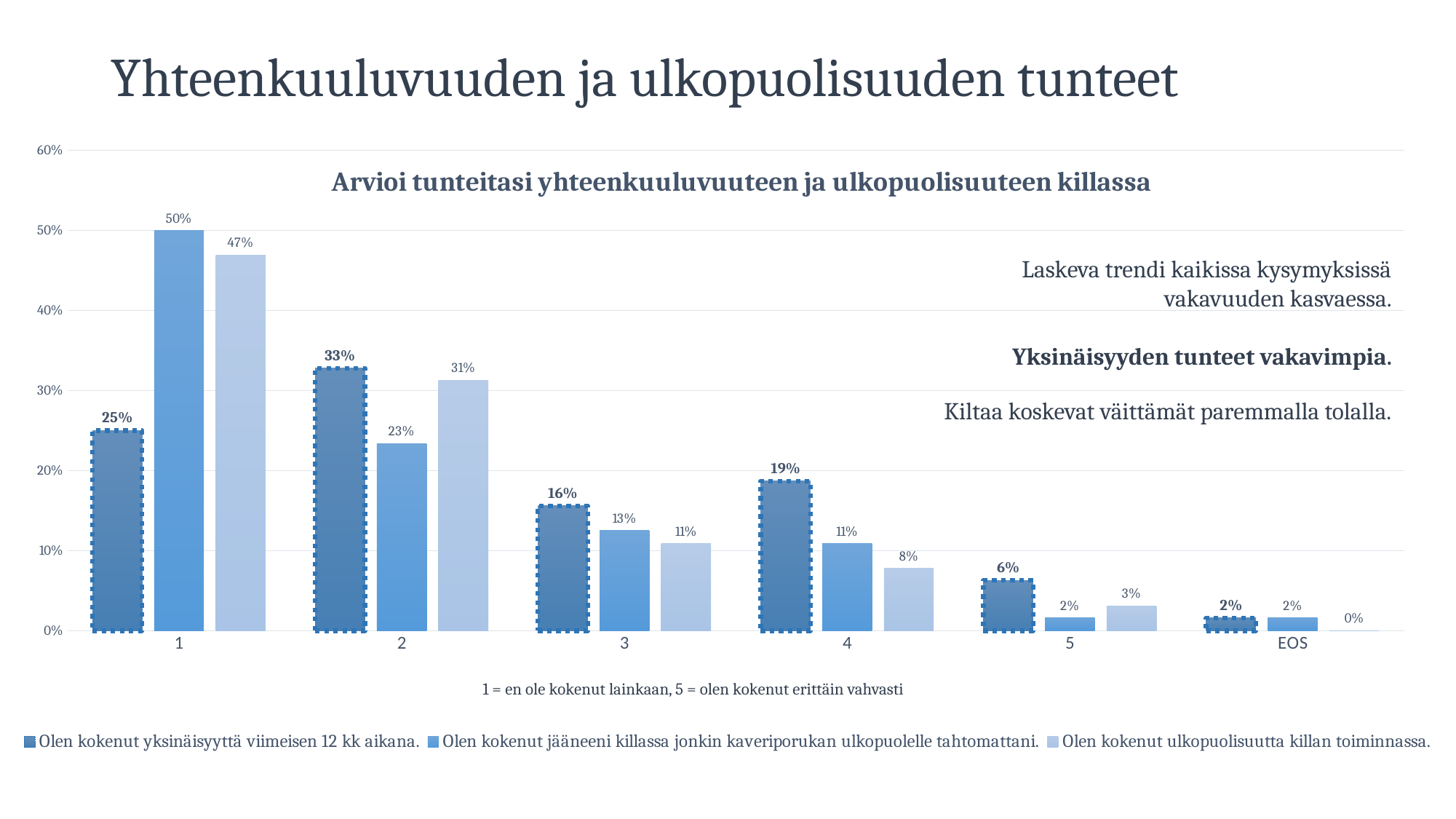
How many series does the legend list? 3 For category 3, which series has the larger value: "Olen kokenut yksinäisyyttä viimeisen 12 kk aikana." or "Olen kokenut ulkopuolisuutta killan toiminnassa."? Olen kokenut yksinäisyyttä viimeisen 12 kk aikana. What is the value for category 2 in the series "Olen kokenut ulkopuolisuutta killan toiminnassa."? 31% How many categories are shown on the x axis? 6 What is the difference between the values for category 1 in the series "Olen kokenut jääneeni killassa jonkin kaveriporukan ulkopuolelle tahtomattani." and "Olen kokenut yksinäisyyttä viimeisen 12 kk aikana."? 25% Which category has the highest value in the series "Olen kokenut yksinäisyyttä viimeisen 12 kk aikana."? 2 What is the value for category 1 in the series "Olen kokenut yksinäisyyttä viimeisen 12 kk aikana."? 25% Which category has the lowest value in the series "Olen kokenut ulkopuolisuutta killan toiminnassa."? EOS What type of chart is shown on the slide? bar chart Do the values for the series "Olen kokenut jääneeni killassa jonkin kaveriporukan ulkopuolelle tahtomattani." rise or fall from category 1 to category 5? fall What is the value for category 4 in the series "Olen kokenut jääneeni killassa jonkin kaveriporukan ulkopuolelle tahtomattani."? 11% What is the title printed inside the chart area? Arvioi tunteitasi yhteenkuuluvuuteen ja ulkopuolisuuteen killassa